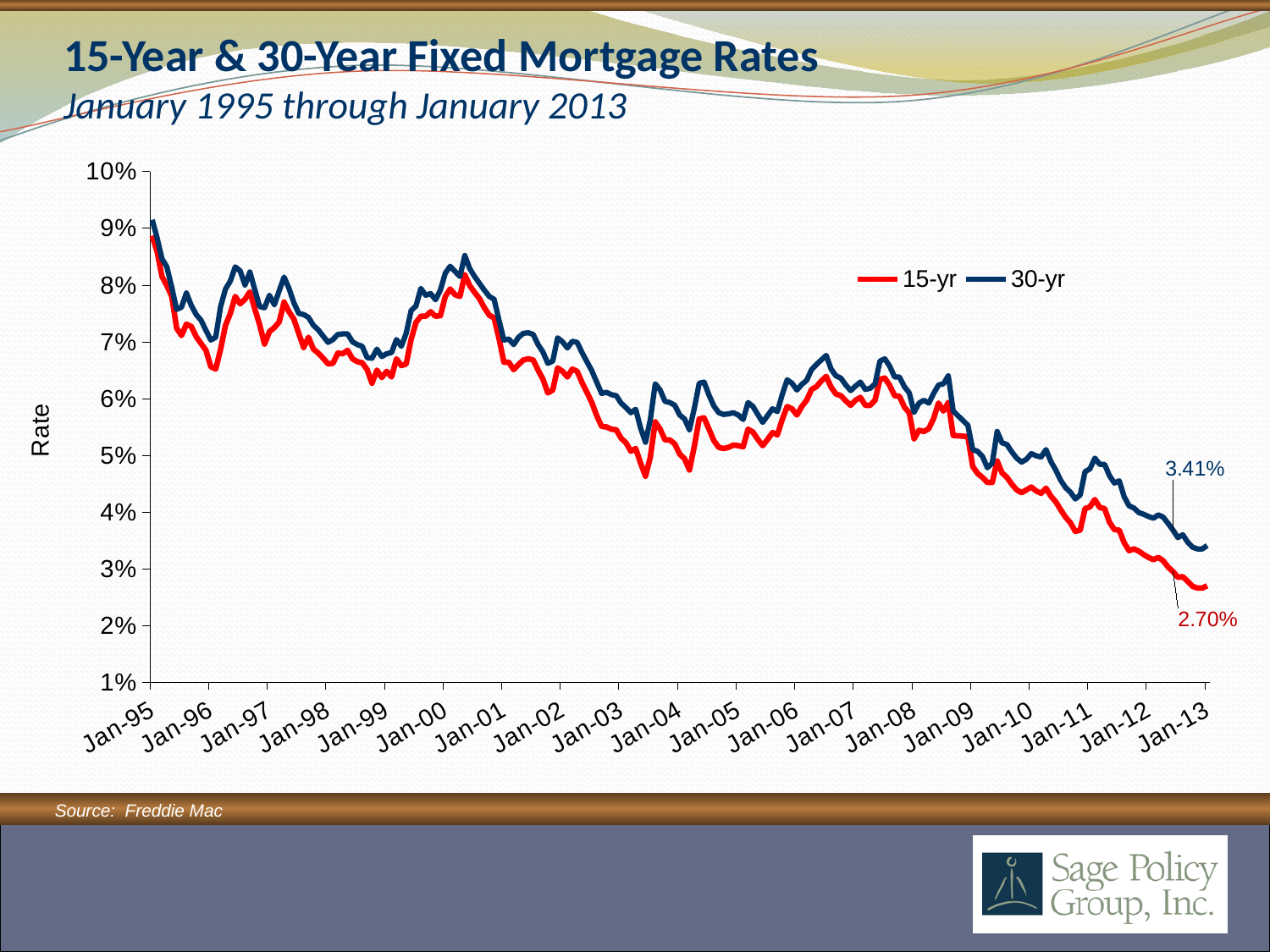
At Jan-13, which series has the higher rate, 15-yr or 30-yr? 30-yr What is the 30-yr fixed mortgage rate at the end of the series (Jan-13)? 3.41% What is the difference between the 30-yr rate (3.41%) and the 15-yr rate (2.70%) at Jan-13? 0.71% Do the mortgage rates overall rise or fall from Jan-95 to Jan-13? Fall How many year labels are shown on the x axis? 19 Is the 30-yr rate at Jan-95 greater or less than 8%? greater Is the 30-yr rate at Jan-10 greater or less than 4%? greater What kind of chart is shown on the slide? Line chart What colour is the 15-yr line in the legend? Red What is the 15-yr fixed mortgage rate at the end of the series (Jan-13)? 2.70% What is the title of the chart on the slide? 15-Year & 30-Year Fixed Mortgage Rates How many series does the legend list? 2